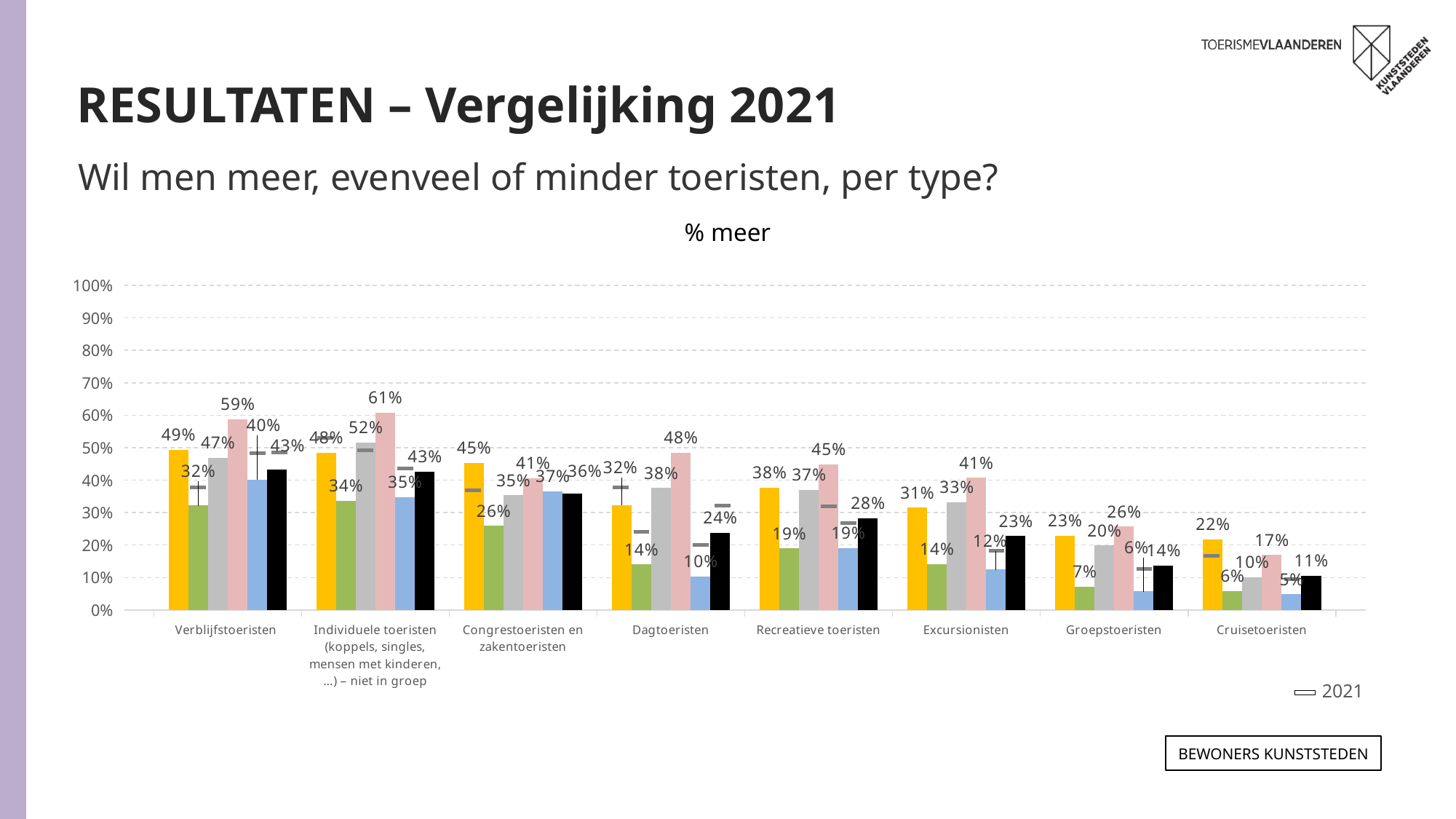
What type of chart is shown on the slide? bar chart What is the lowest value shown for Groepstoeristen? 6% What is the lowest value labelled anywhere on the chart, and for which category? 5%, Cruisetoeristen What is the value of the yellow bar for Cruisetoeristen? 22% Which entry is listed in the chart's legend? 2021 What is the title of the chart? % meer What is the difference between the highest and lowest values shown for Verblijfstoeristen? 27% What is the highest value shown for Dagtoeristen? 48% Which is larger: the pink bar for Excursionisten or the pink bar for Groepstoeristen? Excursionisten What is the highest value labelled anywhere on the chart, and for which category? 61%, Individuele toeristen How many tourist-type categories are shown along the x axis of the chart? 8 What is the value of the black bar for Recreatieve toeristen? 28%